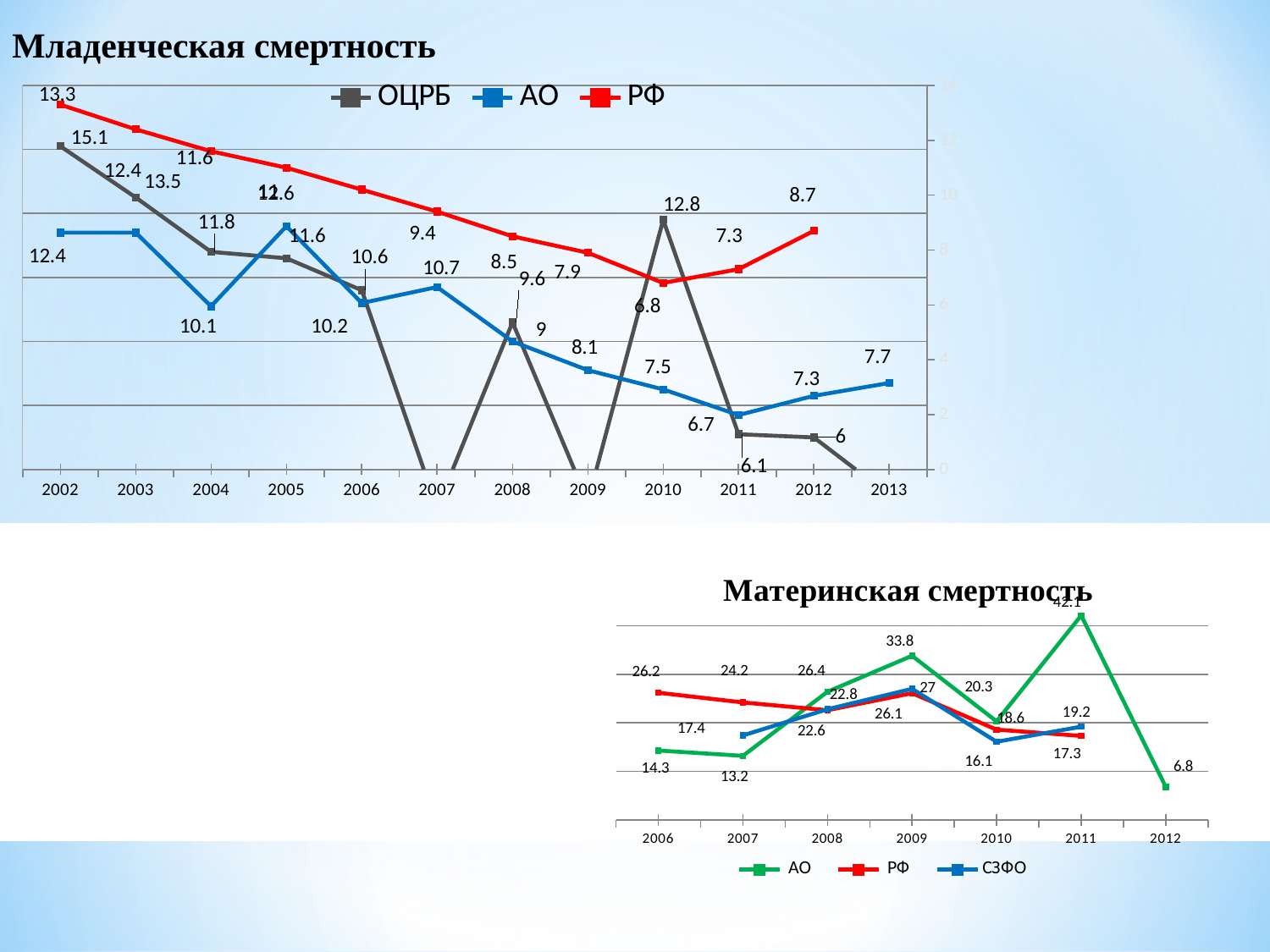
In the top chart 'Младенческая смертность', does the РФ line rise or fall from 2002 to 2010? Fall In the top chart 'Младенческая смертность', what is the value for РФ in 2002? 13.3 In the bottom chart 'Материнская смертность', in which year is the АО value lowest? 2012 In the bottom chart 'Материнская смертность', what is the value for АО in 2009? 33.8 In the top chart 'Младенческая смертность', what is the value for АО in 2013? 7.7 In the bottom chart 'Материнская смертность', in which year is the АО value highest? 2011 In the bottom chart 'Материнская смертность', which is larger in 2006: the value for РФ or the value for АО? РФ In the top chart 'Младенческая смертность', what is the value for ОЦРБ in 2010? 12.8 In the top chart 'Младенческая смертность', what kind of chart is shown? Line chart In the top chart 'Младенческая смертность', what is the difference between the РФ values in 2002 and 2012? 4.6 In the bottom chart 'Материнская смертность', how many years are shown on the x axis? 7 In the top chart 'Младенческая смертность', how many series does the legend list? 3